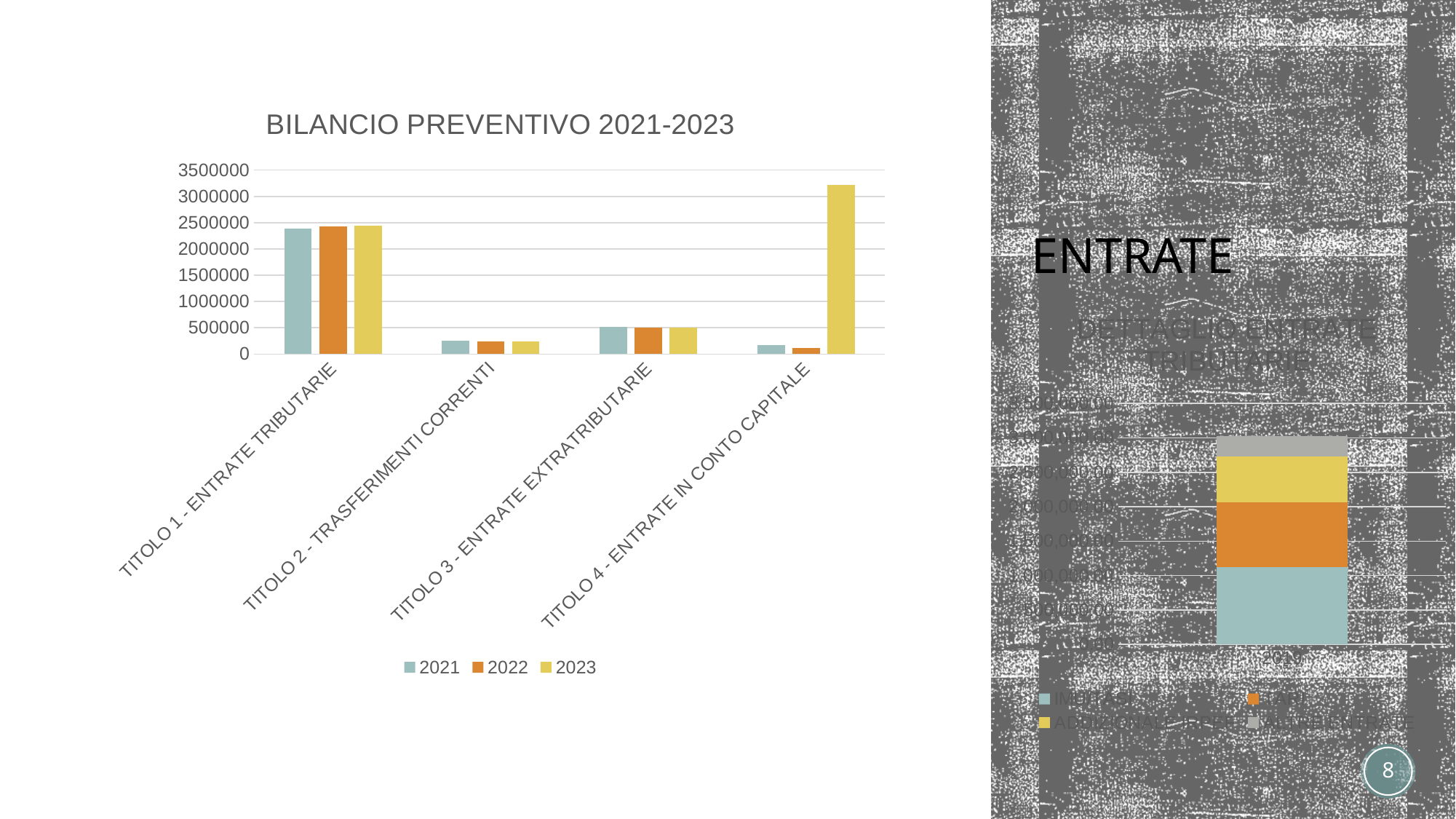
In the chart titled 'BILANCIO PREVENTIVO 2021-2023', how many categories are shown on the x axis? 4 In the chart titled 'BILANCIO PREVENTIVO 2021-2023', is the 2023 value for TITOLO 2 - TRASFERIMENTI CORRENTI greater or less than 500000? less In the chart titled 'BILANCIO PREVENTIVO 2021-2023', which category has the lowest value for 2022? TITOLO 4 - ENTRATE IN CONTO CAPITALE In the chart titled 'BILANCIO PREVENTIVO 2021-2023', which series are listed in the legend? 2021, 2022, 2023 In the chart titled 'BILANCIO PREVENTIVO 2021-2023', which has the larger 2021 value, TITOLO 1 - ENTRATE TRIBUTARIE or TITOLO 3 - ENTRATE EXTRATRIBUTARIE? TITOLO 1 - ENTRATE TRIBUTARIE In the chart titled 'BILANCIO PREVENTIVO 2021-2023', which category has the lowest value for 2023? TITOLO 2 - TRASFERIMENTI CORRENTI In the chart titled 'BILANCIO PREVENTIVO 2021-2023', which category has the tallest bar for 2023? TITOLO 4 - ENTRATE IN CONTO CAPITALE In the chart titled 'BILANCIO PREVENTIVO 2021-2023', what kind of chart is shown? Bar chart In the chart titled 'BILANCIO PREVENTIVO 2021-2023', is the 2021 value for TITOLO 1 - ENTRATE TRIBUTARIE greater or less than 2000000? greater In the chart titled 'BILANCIO PREVENTIVO 2021-2023', is the 2023 value for TITOLO 4 - ENTRATE IN CONTO CAPITALE greater or less than 3000000? greater In the chart titled 'BILANCIO PREVENTIVO 2021-2023', for TITOLO 4 - ENTRATE IN CONTO CAPITALE, which year has the larger value, 2022 or 2023? 2023 In the chart titled 'BILANCIO PREVENTIVO 2021-2023', how many series does the legend list? 3